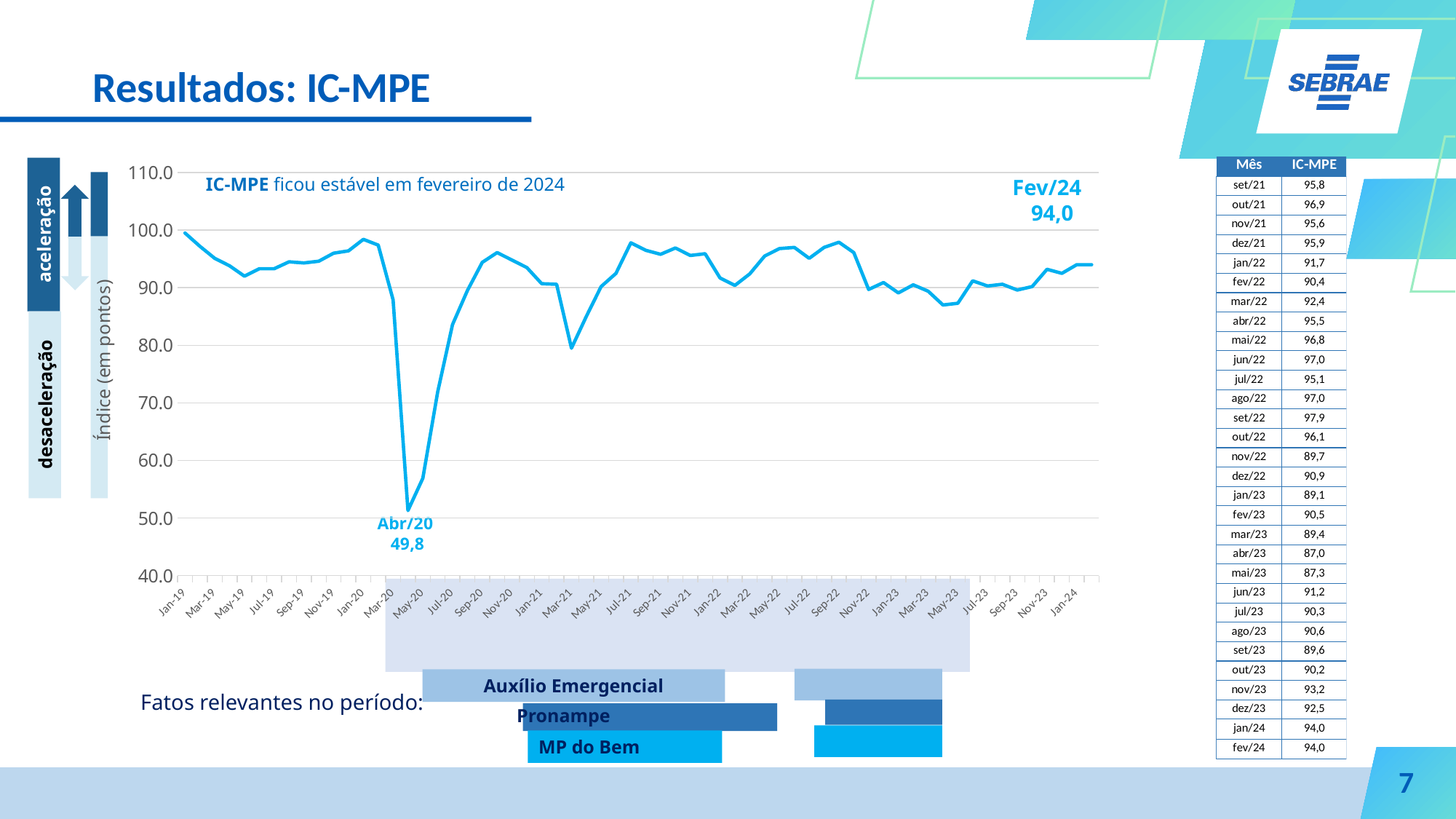
Is the IC-MPE value at the dip around Mar-21 greater or less than 90? less What is the IC-MPE value labelled at Fev/24 on the chart? 94,0 Is the IC-MPE value at Jan-19 greater or less than 90? greater What is the difference between the Fev/24 value and the Abr/20 value on the chart? 44,2 How many lines are plotted on the chart? 1 Which is larger, the IC-MPE value at Fev/24 or at Abr/20? Fev/24 At which month does the IC-MPE line reach its lowest point? Abr/20 What is the IC-MPE value labelled at Abr/20 on the chart? 49,8 What is the label on the vertical axis of the chart? Índice (em pontos) Is the IC-MPE value at Jul-21 greater or less than 90? greater What kind of chart is shown on the slide? line chart What text is shown as the chart's title inside the plot area? IC-MPE ficou estável em fevereiro de 2024